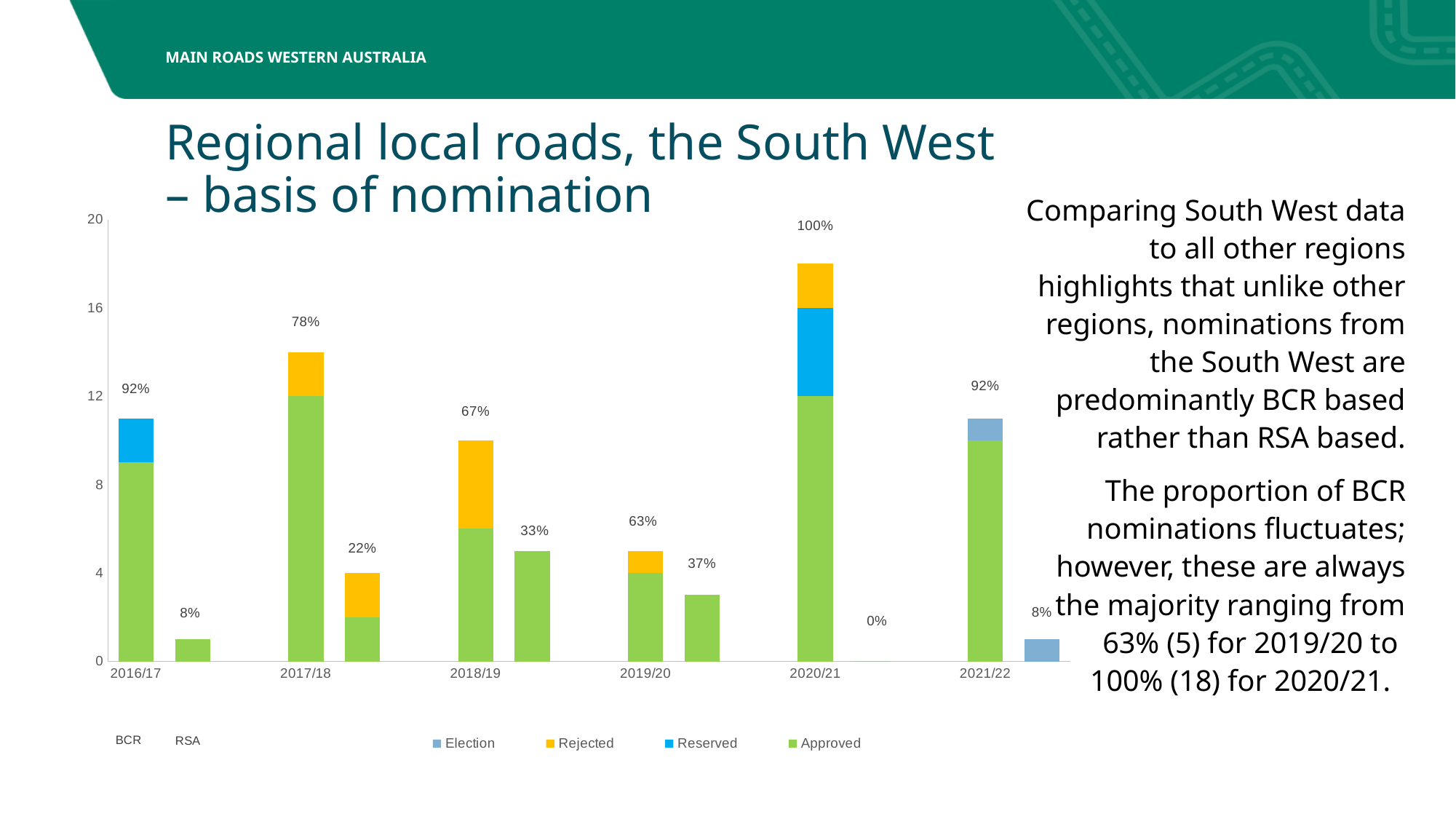
Which year has the lowest percentage label for RSA nominations? 2020/21 How many financial years are shown on the x axis? 6 What colour represents the Approved series in the legend? Green What percentage label is shown above the RSA bar for 2019/20? 37% Which has the larger BCR percentage label, 2017/18 or 2018/19? 2017/18 What kind of chart is shown on the slide? Stacked bar chart Is the total height of the BCR bar for 2019/20 greater or less than 8? less What percentage label is shown above the BCR bar for 2020/21? 100% Which year has the highest percentage label for BCR nominations? 2020/21 What is the difference between the BCR and RSA percentage labels for 2017/18? 56 percentage points Is the total height of the BCR bar for 2020/21 greater or less than 16? greater How many series does the chart legend list? 4